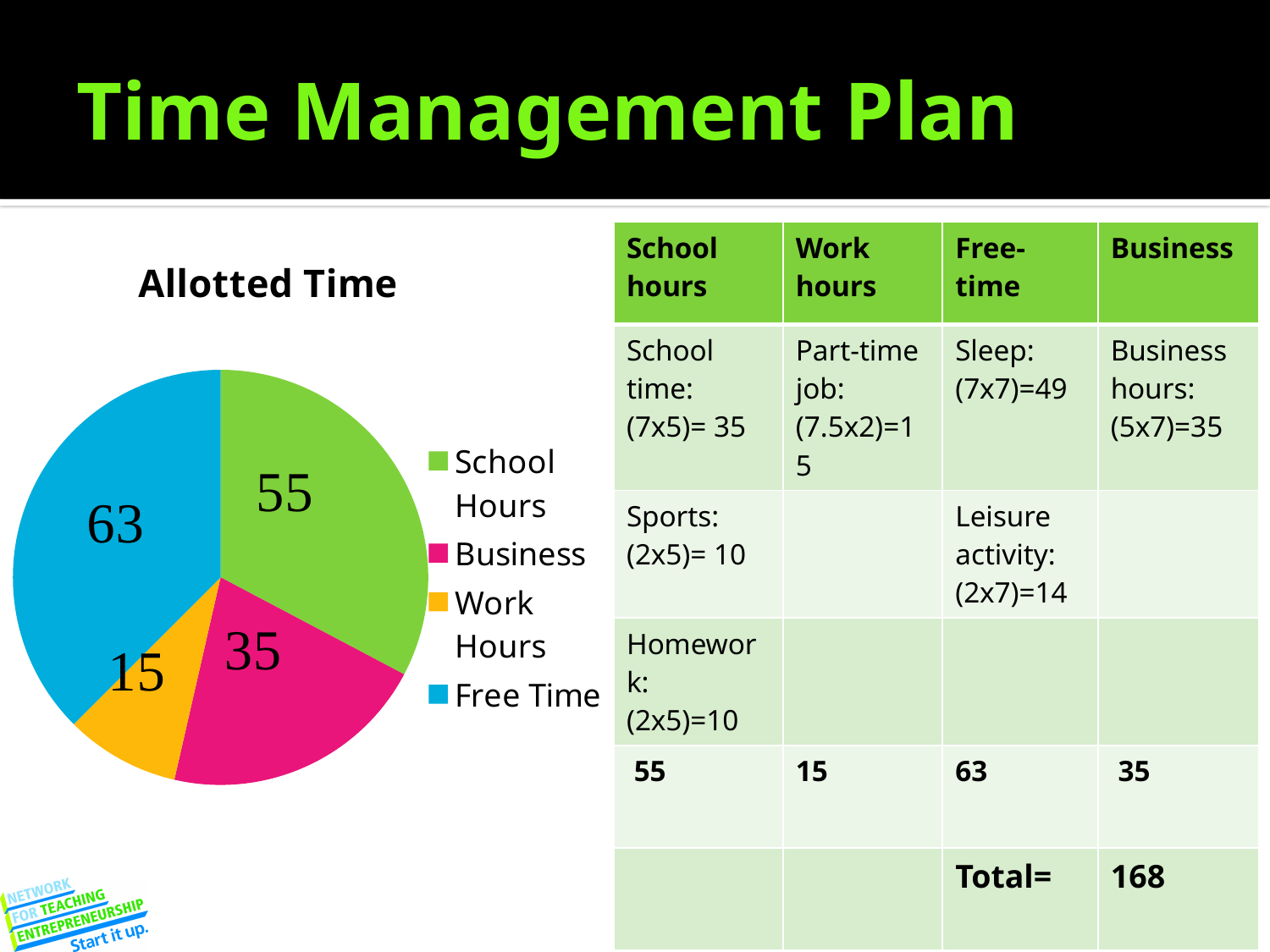
What value is shown for Free Time in the pie chart? 63 How many categories does the pie chart legend list? 4 What value is shown for School Hours in the pie chart? 55 What value is shown for Business in the pie chart? 35 What type of chart is shown on the slide? Pie chart What is the title of the chart? Allotted Time What is the difference between the Free Time value and the School Hours value? 8 Which is larger in the pie chart, Business or Work Hours? Business What value is shown for Work Hours in the pie chart? 15 What share of the pie does the Free Time slice represent? 37.5% Which category has the smallest slice of the pie chart? Work Hours Which category has the largest slice of the pie chart? Free Time